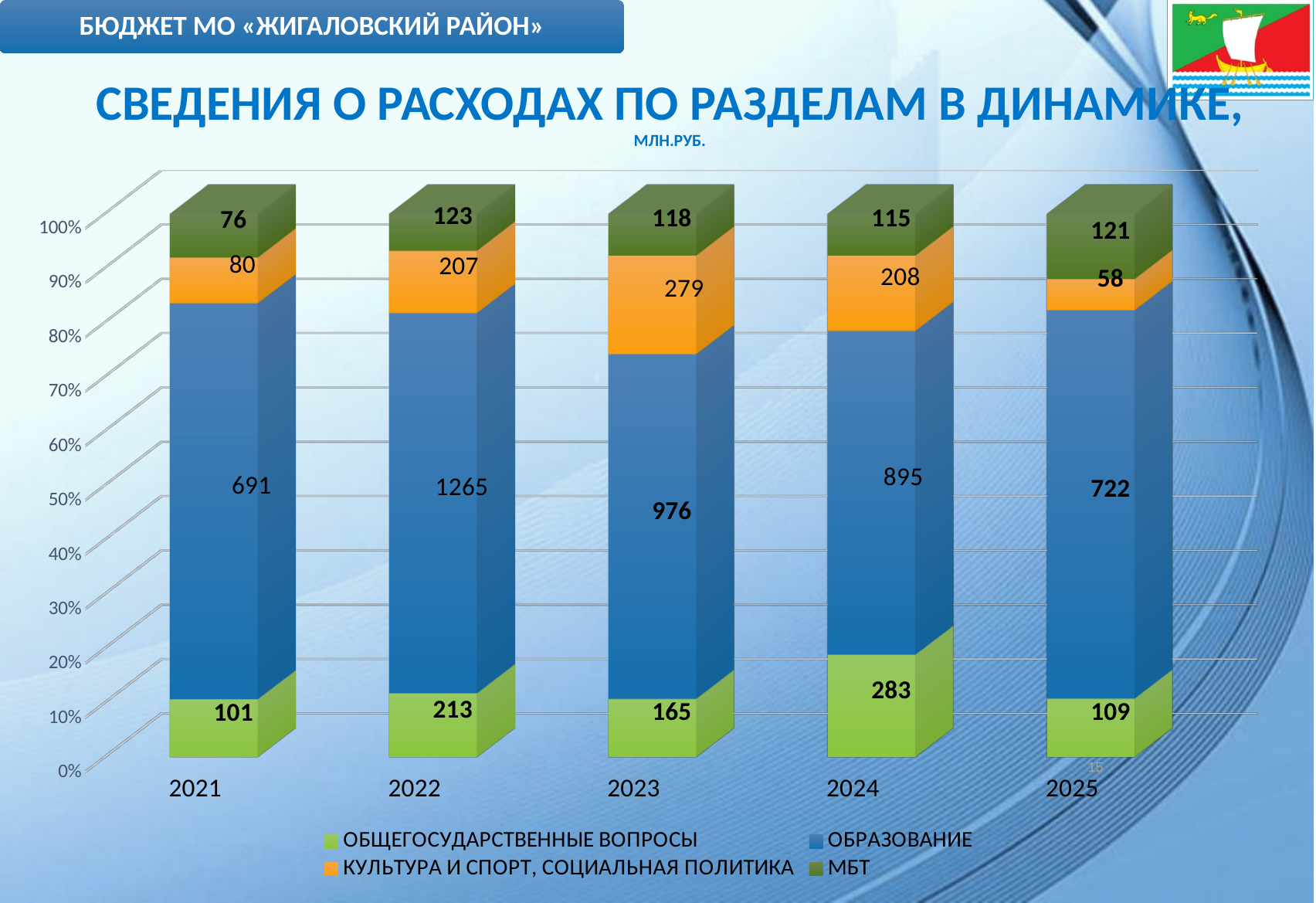
How many years are shown on the x axis? 5 What is the value for ОБЩЕГОСУДАРСТВЕННЫЕ ВОПРОСЫ in 2024? 283 What is the total of all four segments in the 2021 bar? 948 In which year is the value for ОБРАЗОВАНИЕ the highest? 2022 In which year is the value for КУЛЬТУРА И СПОРТ, СОЦИАЛЬНАЯ ПОЛИТИКА the lowest? 2025 What is the difference between the ОБРАЗОВАНИЕ values for 2022 and 2021? 574 Which is larger: the МБТ value for 2022 or for 2024? 2022 What is the value for КУЛЬТУРА И СПОРТ, СОЦИАЛЬНАЯ ПОЛИТИКА in 2023? 279 What is the value for ОБРАЗОВАНИЕ in 2022? 1265 How many series does the legend list? 4 What kind of chart is shown on the slide? Stacked bar chart What is the value for МБТ in 2025? 121